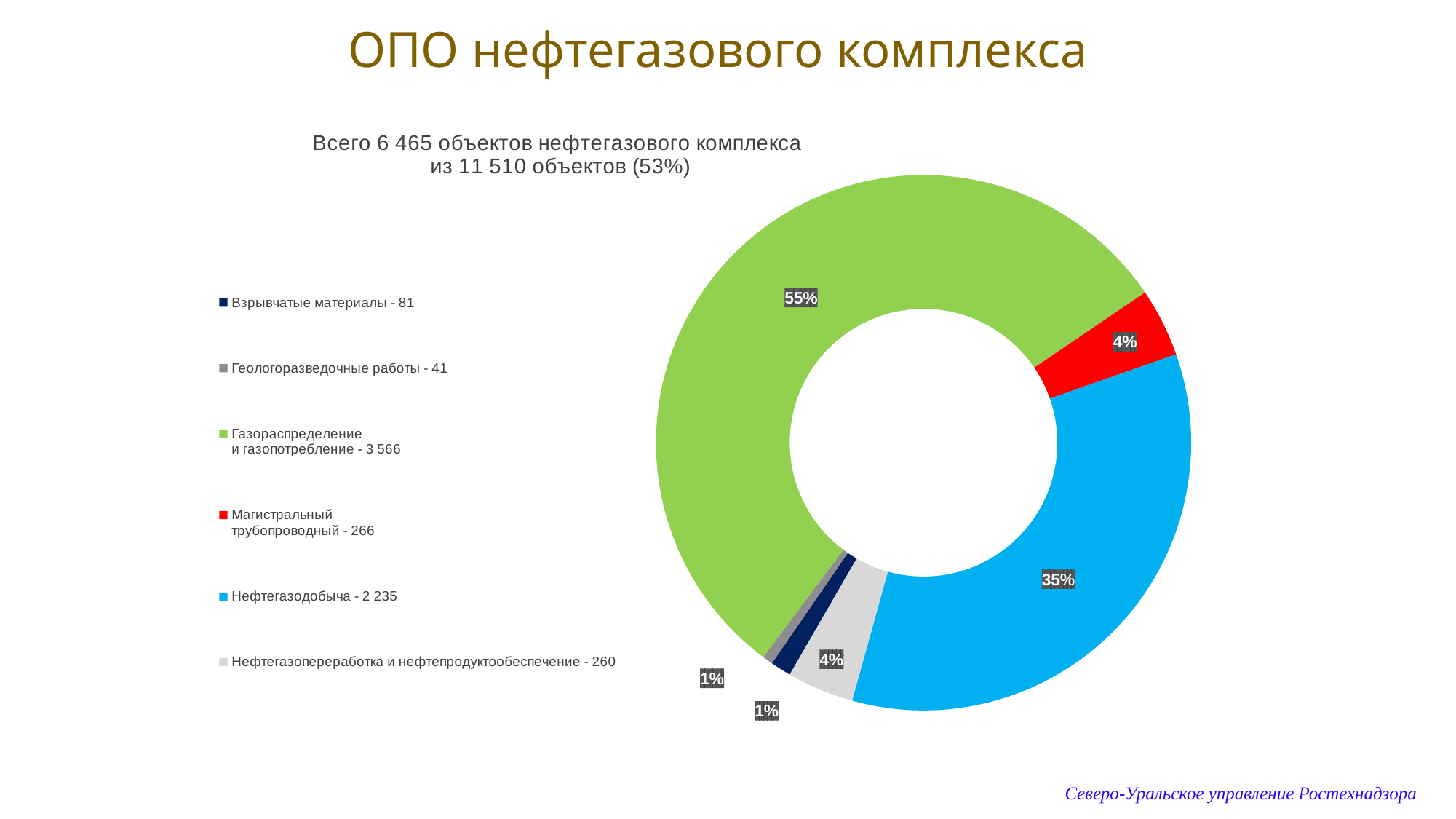
How many categories does the chart show? 6 Which category has the largest share of the chart? Газораспределение и газопотребление What kind of chart is shown on the slide? Doughnut (pie) chart What is the number of objects for Нефтегазодобыча according to the legend? 2 235 What is the difference between the number of objects for Газораспределение и газопотребление and Нефтегазодобыча? 1 331 What share of the chart does Магистральный трубопроводный take? 4% What is the number of objects for Геологоразведочные работы according to the legend? 41 What share of the chart does Нефтегазодобыча take? 35% What share of the chart does Газораспределение и газопотребление take? 55% Which has more objects: Магистральный трубопроводный or Нефтегазопереработка и нефтепродуктообеспечение? Магистральный трубопроводный What is the total number of oil and gas complex objects stated on the slide? 6 465 Which category has the smallest number of objects according to the legend? Геологоразведочные работы